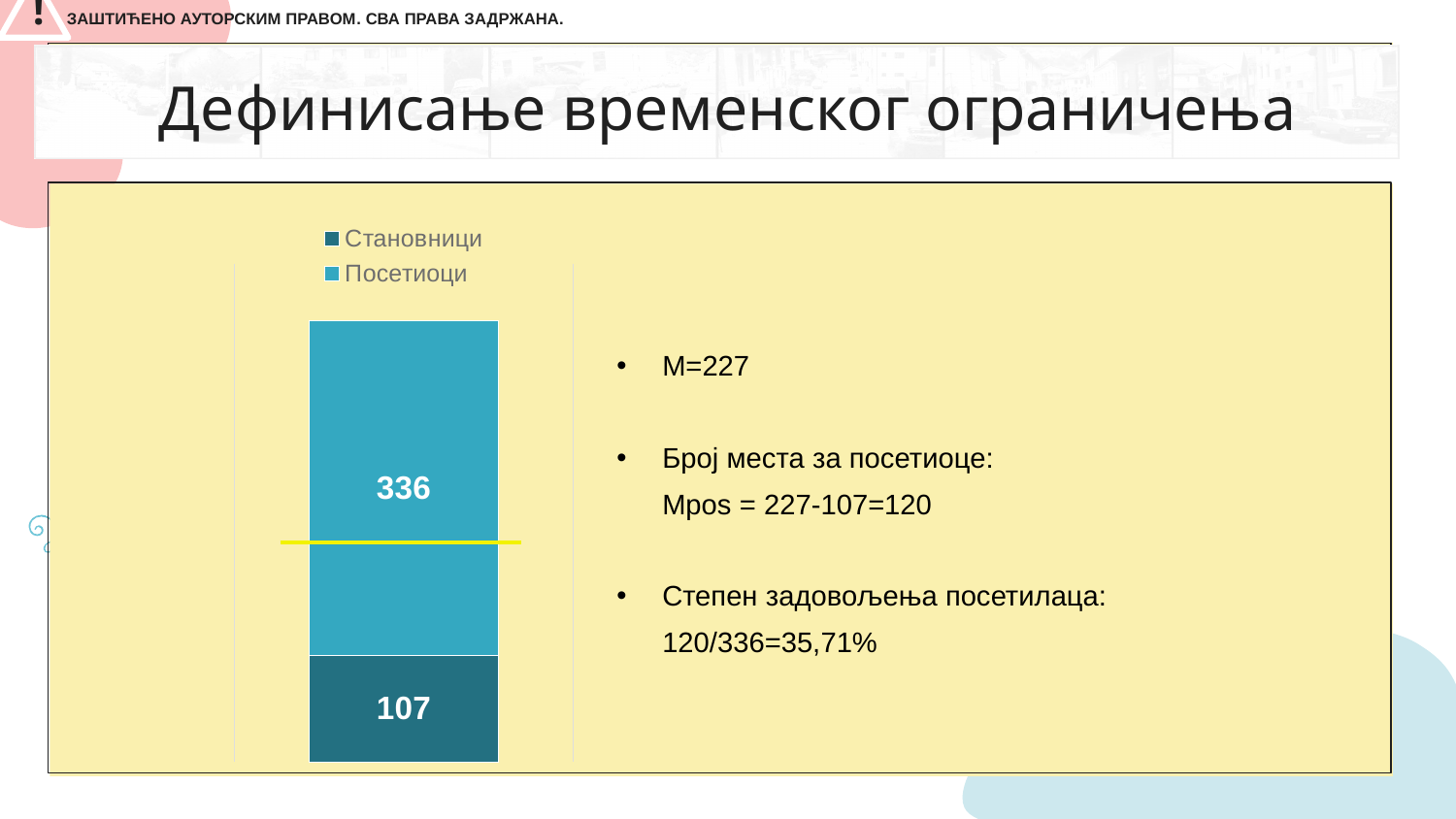
Which series has the largest value in the chart? Посетиоци Which legend entry is listed first in the chart? Становници How many bars are plotted in the chart? 1 How many series does the chart legend list? 2 What is the difference between the Посетиоци value and the Становници value? 229 What is the total of the stacked bar? 443 Which series is shown in the darker teal colour at the bottom of the bar? Становници What kind of chart is shown on the slide? stacked bar chart Which series has the smallest value in the chart? Становници What is the value for Становници in the chart? 107 What is the value for Посетиоци in the chart? 336 Which series has the larger value, Становници or Посетиоци? Посетиоци